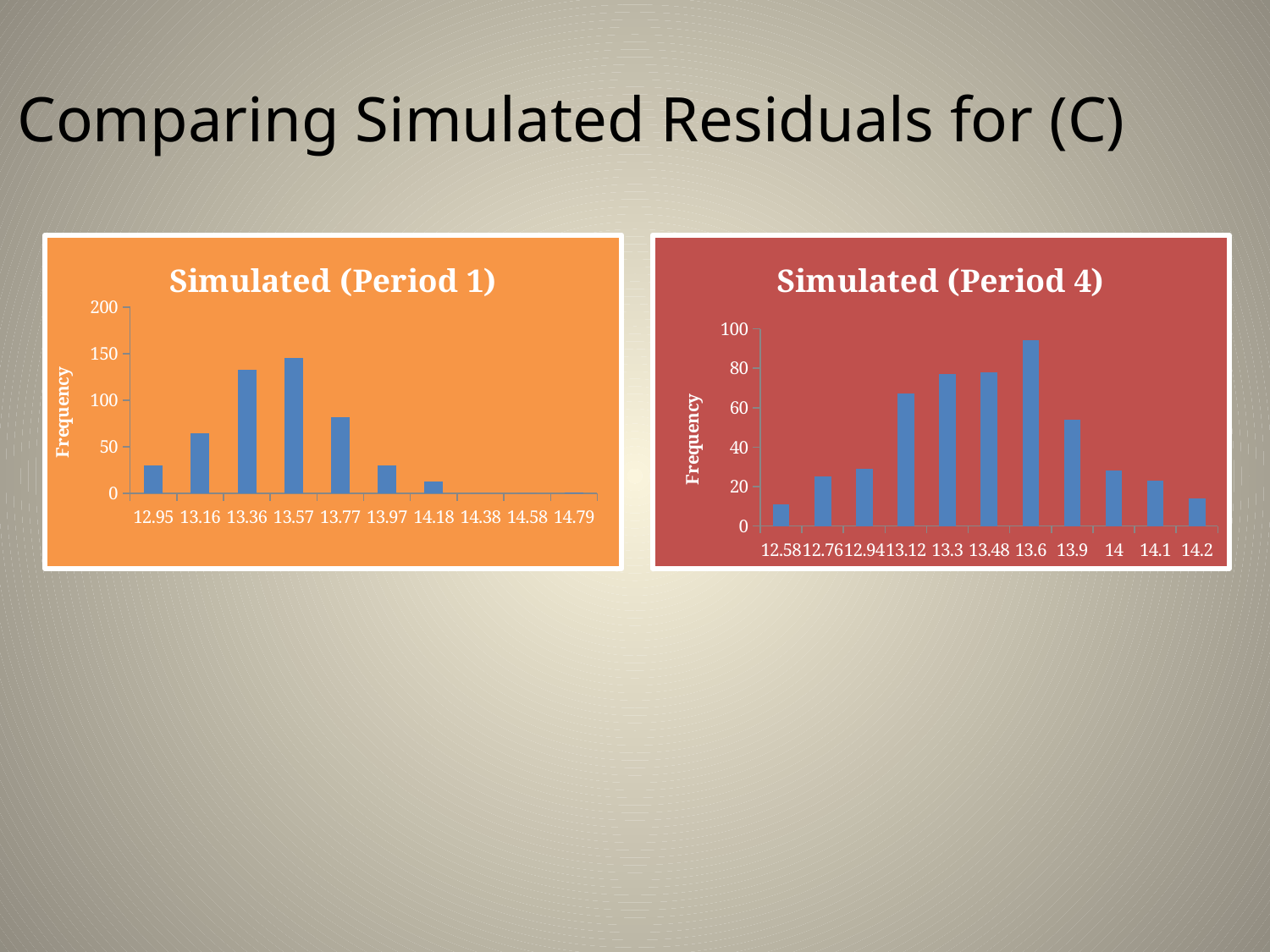
In the Simulated (Period 4) chart, which x-axis category has the lowest frequency? 12.58 In the Simulated (Period 1) chart, is the frequency for 13.36 greater or less than 100? greater In the Simulated (Period 1) chart, which has the higher frequency, 13.16 or 13.77? 13.77 What is the y-axis label on the Simulated (Period 1) chart? Frequency In the Simulated (Period 4) chart, is the frequency for 13.6 greater or less than 80? greater In the Simulated (Period 1) chart, which x-axis category has the highest frequency? 13.57 What kind of chart is the Simulated (Period 1) chart? bar chart In the Simulated (Period 4) chart, which has the higher frequency, 13.12 or 14.1? 13.12 In the Simulated (Period 1) chart, is the frequency for 13.97 greater or less than 50? less In the Simulated (Period 4) chart, which x-axis category has the highest frequency? 13.6 How many x-axis categories are labelled in the Simulated (Period 4) chart? 11